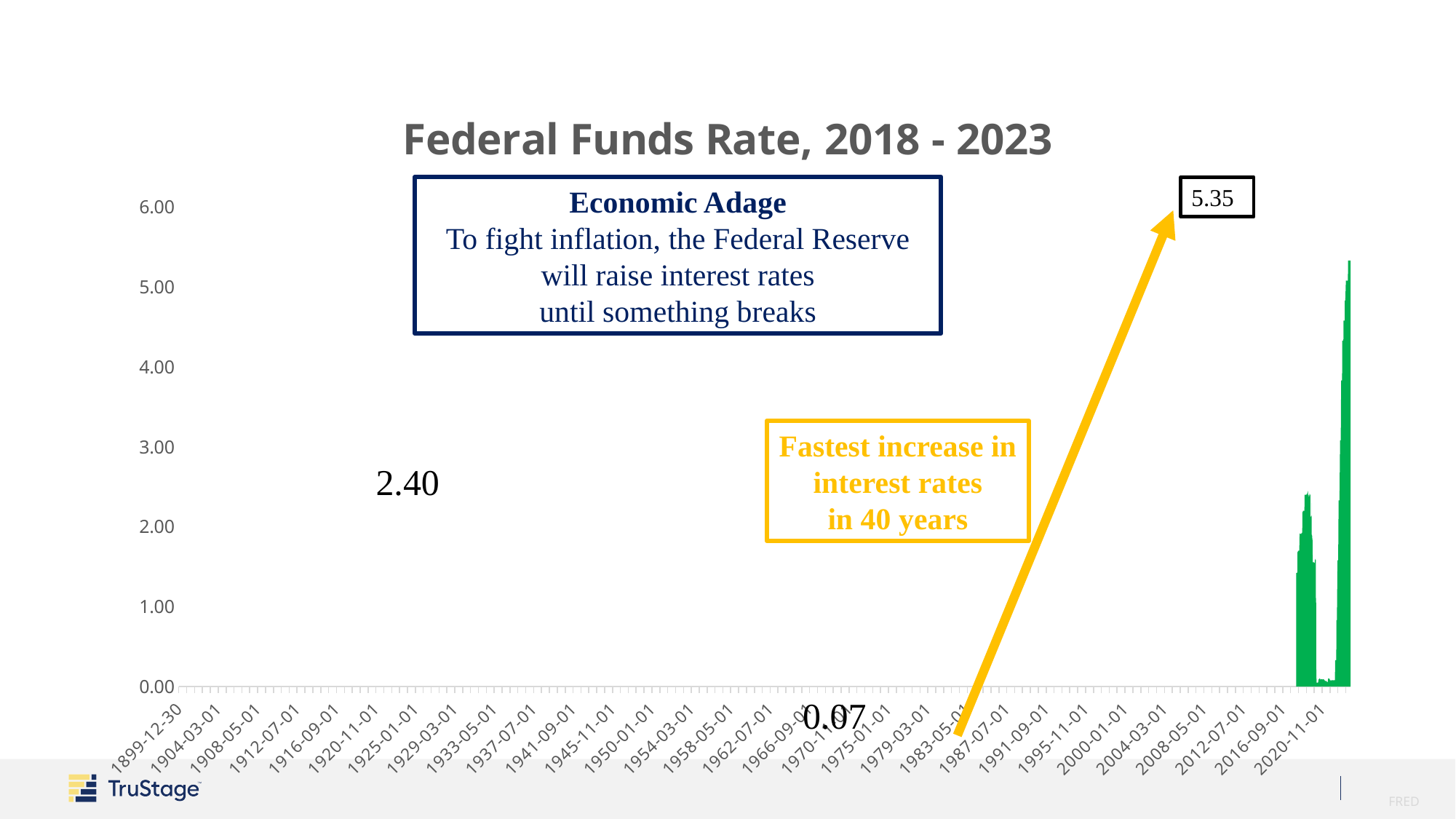
What is the difference between the labelled peak value of 5.35 and the labelled low of 0.07? 5.28 What is the highest value labelled on the chart? 5.35 Is the earlier peak of the Federal Funds Rate greater or less than 3.00? less Is the final peak of the Federal Funds Rate greater or less than 5.00? greater Which labelled value is larger, 2.40 or 5.35? 5.35 How many data values are labelled on the chart? 3 What is the difference between the labelled values 5.35 and 2.40? 2.95 What does the yellow annotation box on the chart say? Fastest increase in interest rates in 40 years What value is labelled for the earlier, smaller peak of the Federal Funds Rate? 2.40 From the labelled low of 0.07 to the end of the series, does the Federal Funds Rate rise or fall? rise What is the title of the chart? Federal Funds Rate, 2018 - 2023 What is the lowest value labelled on the chart? 0.07